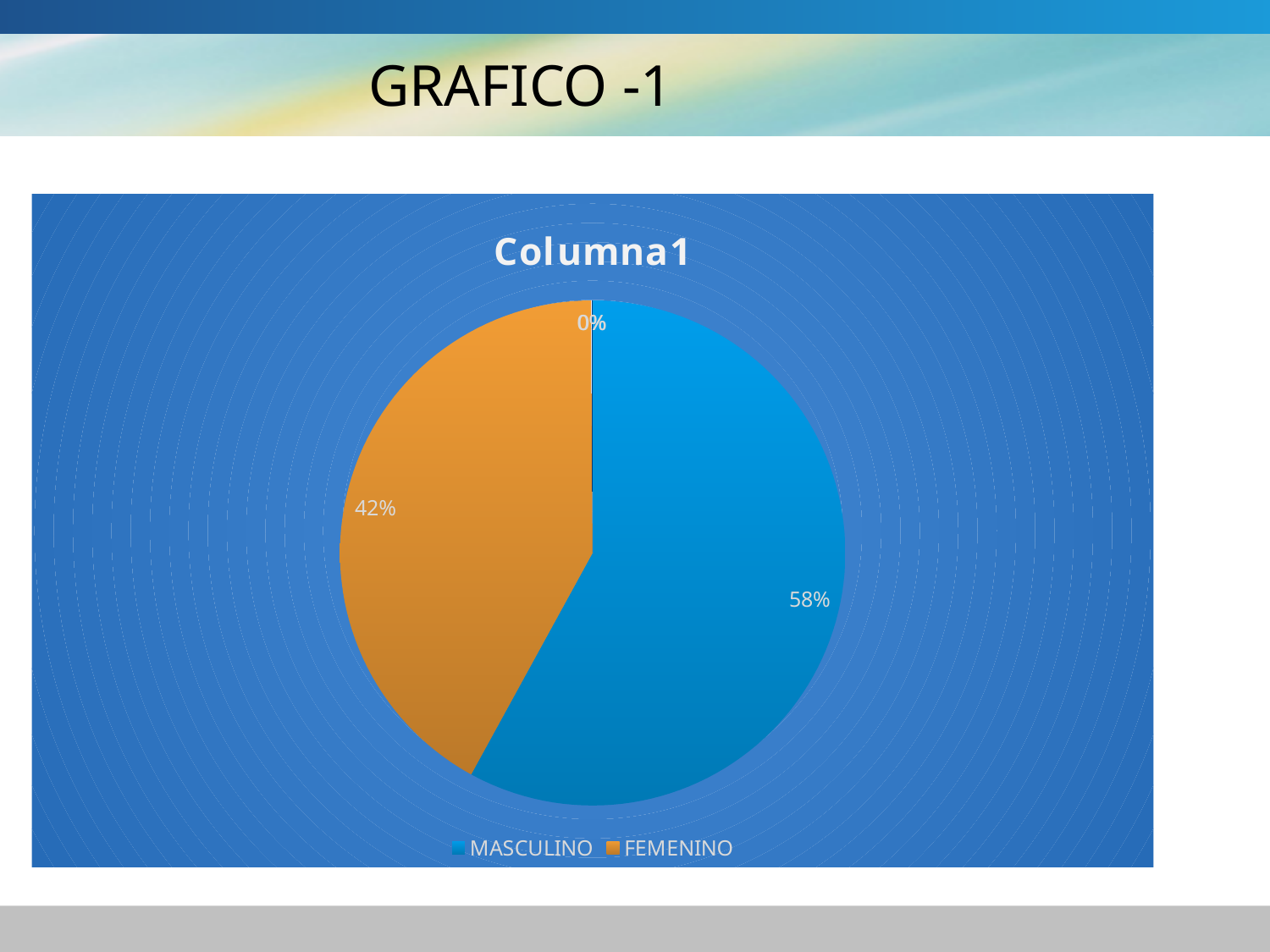
What share of the pie does MASCULINO represent? 58% What is the combined share of the MASCULINO and FEMENINO slices? 100% Is the MASCULINO slice larger or smaller than the FEMENINO slice? larger What kind of chart is shown on the slide? pie chart Is the share for MASCULINO greater or less than 50%? greater What is the title of the chart? Columna1 What is the difference in percentage points between the MASCULINO and FEMENINO slices? 16% Which category has the largest slice of the pie? MASCULINO What colour is the FEMENINO slice? orange Which of the two labelled categories, MASCULINO or FEMENINO, has the smaller slice? FEMENINO What share of the pie does FEMENINO represent? 42% How many categories does the legend list? 2